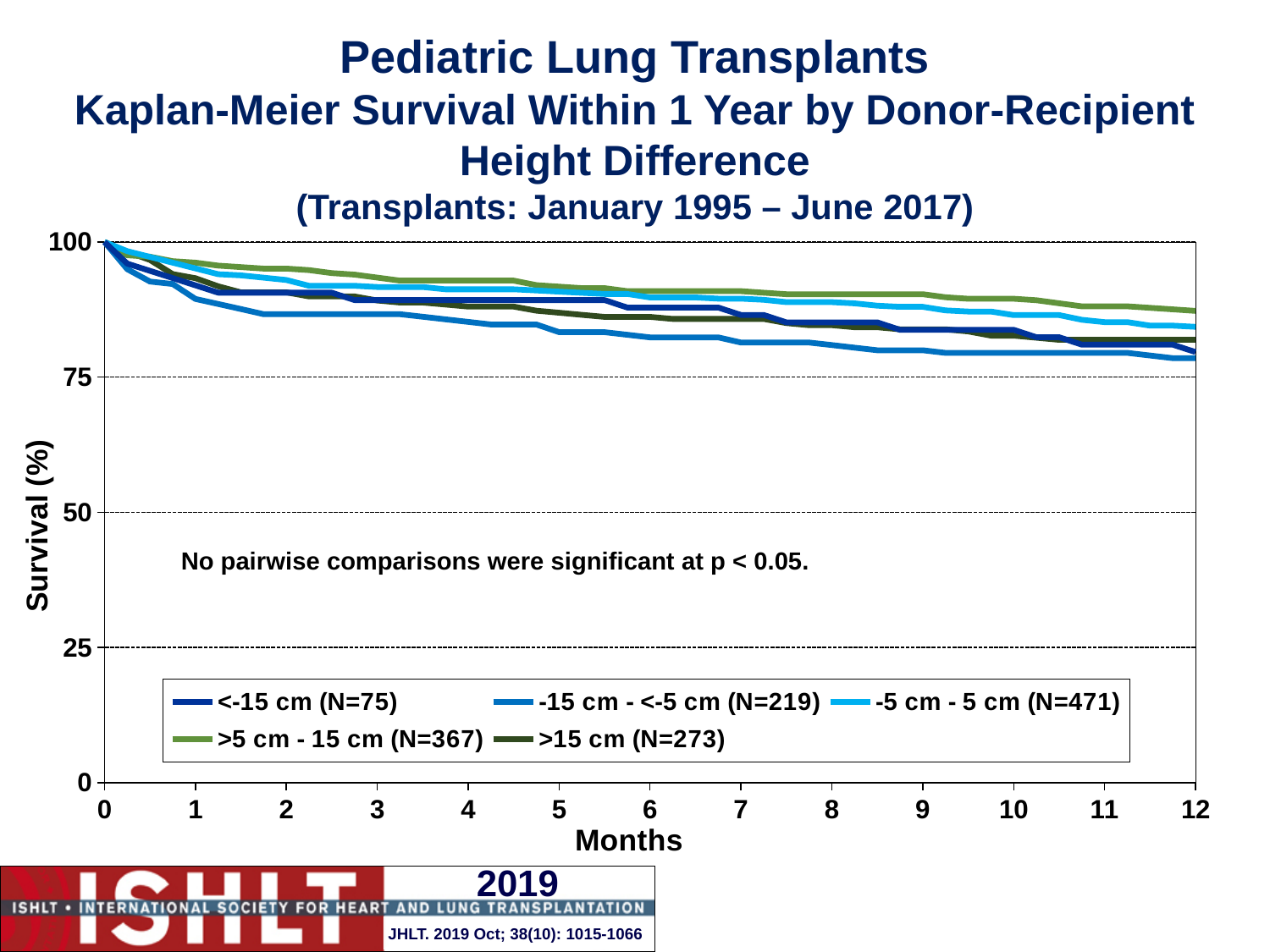
Which height-difference group has the highest survival at 12 months? >5 cm - 15 cm (N=367) What is the label of the x axis? Months Is the survival value for the <-15 cm group at 6 months greater or less than 75? greater How many series does the legend list? 5 What is the maximum value shown on the x axis? 12 Is the survival value for the >5 cm - 15 cm group at 12 months greater or less than 75? greater Do the survival curves rise or fall as months increase? Fall What is the sample size (N) for the -5 cm - 5 cm group shown in the legend? 471 At 12 months, which group has higher survival: >5 cm - 15 cm or -15 cm - <-5 cm? >5 cm - 15 cm Is the survival value for the -15 cm - <-5 cm group at 12 months greater or less than 75? greater What is the survival (%) value for all groups at month 0? 100 What kind of chart is shown on the slide? Line chart